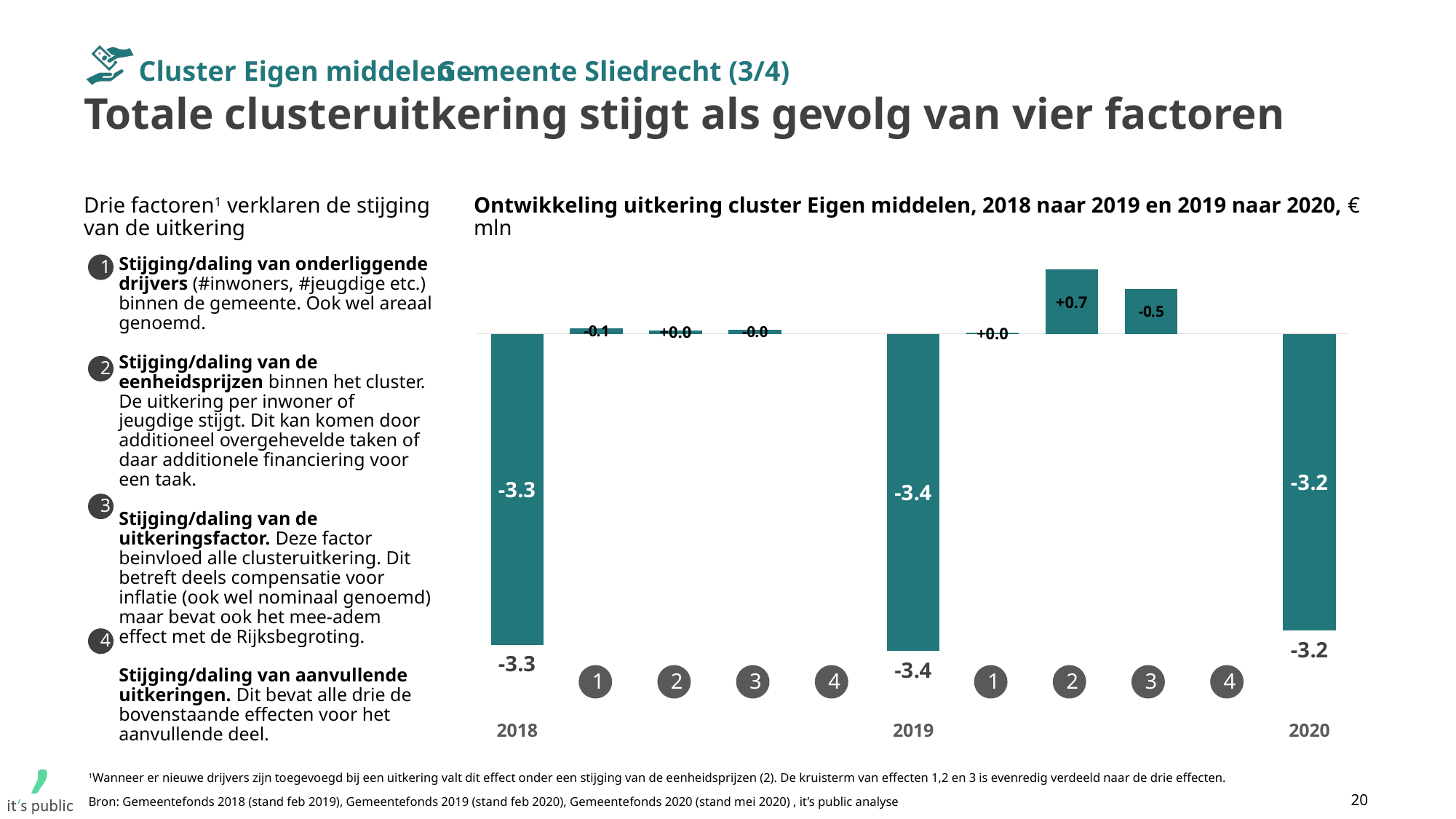
What is the difference between the 2020 total and the 2019 total? 0.2 Which of the three year totals (2018, 2019, 2020) is the highest? 2020 What is the value of the total bar for 2019? -3.4 What is the value of the total bar for 2018? -3.3 What unit is stated in the chart title? € mln What is the value of factor 3 in the change from 2019 to 2020? -0.5 What is the value of the total bar for 2020? -3.2 Which is larger in the change from 2019 to 2020: factor 2 or factor 3? Factor 2 What is the value of factor 2 in the change from 2019 to 2020? +0.7 What is the value of factor 1 in the change from 2018 to 2019? -0.1 Which of the three year totals (2018, 2019, 2020) is the lowest? 2019 What kind of chart is shown on the slide? Bar chart (waterfall)